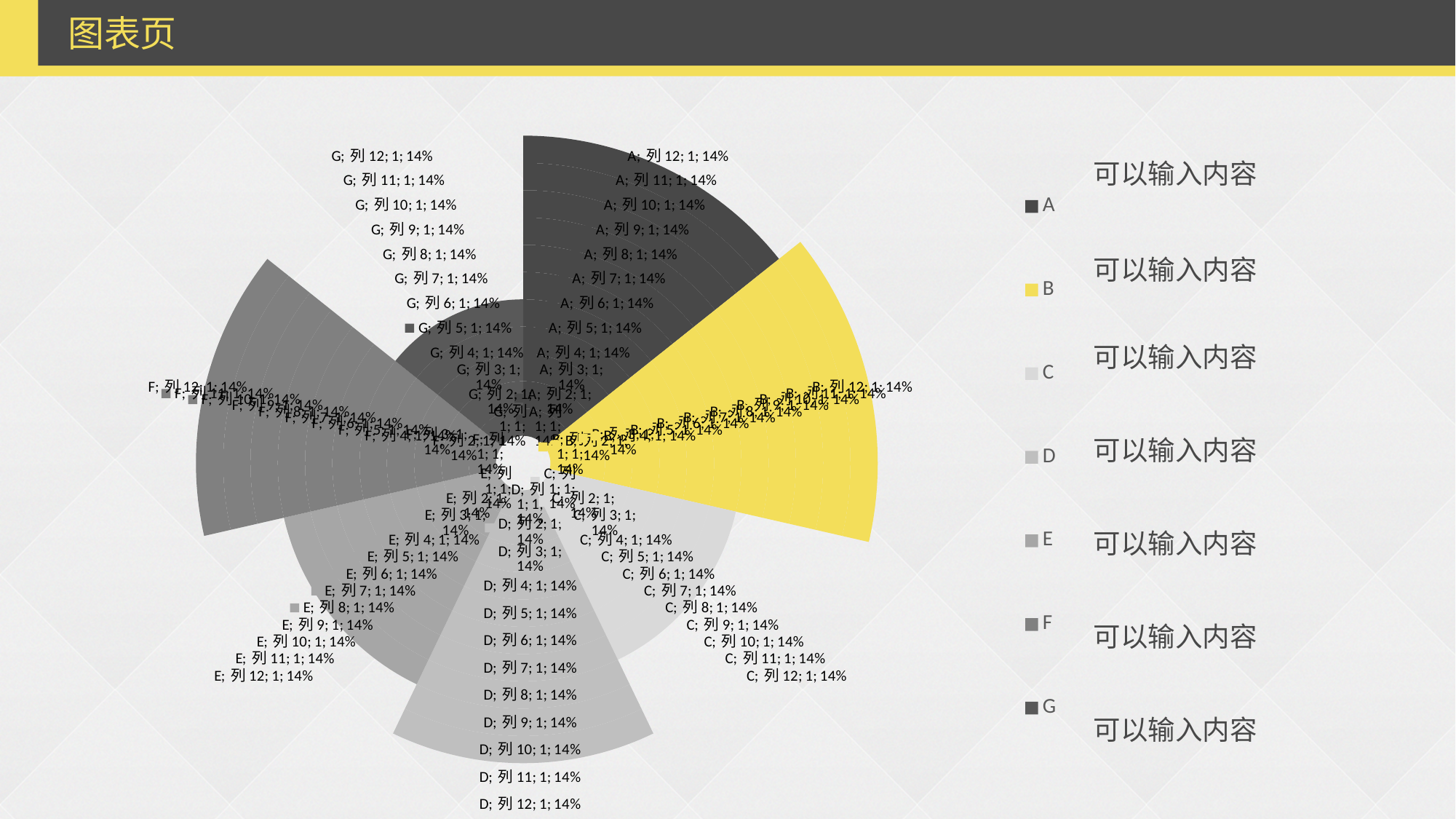
What percentage is shown for the G slice in 列 8? 14% What value is shown for E in 列 9? 1 What value is shown for C in 列 12? 1 What percentage is shown for the D slice in 列 10? 14% What kind of chart is shown on the slide? doughnut chart What percentage is shown for the B slice in 列 12? 14% How many entries does the chart legend list? 7 Is the value for A in 列 12 larger than the value for C in 列 12, or are they equal? equal What is the title of the slide containing the chart? 图表页 Which legend entry is shown in yellow? B What value is shown for A in 列 12? 1